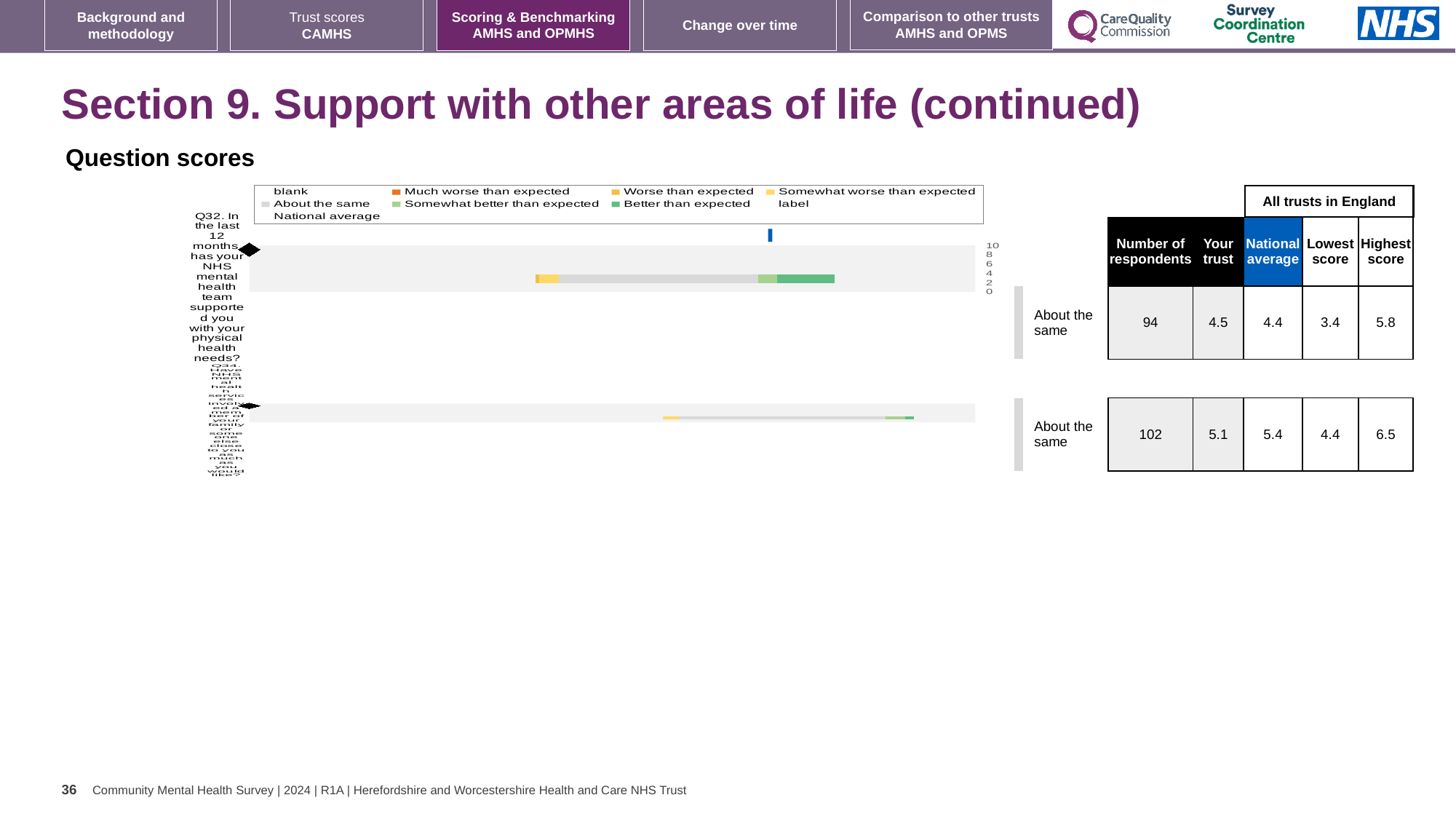
What is the 'Your trust' score for Q32 (support with physical health needs)? 4.5 What is the highest score among all trusts in England for Q34? 6.5 How many respondents answered Q32? 94 What is the national average score for Q34 (involving family or someone close)? 5.4 For Q34, which is larger: the 'Your trust' score or the national average? National average What is the difference between the highest score and the lowest score for Q34? 2.1 For Q32, which is larger: the 'Your trust' score or the national average? Your trust How many entries does the chart legend list? 9 Which question has the higher number of respondents, Q32 or Q34? Q34 How many survey questions are plotted as rows in the chart? 2 What kind of chart is shown on the slide? bar chart What colour does the legend use for 'Better than expected'? green